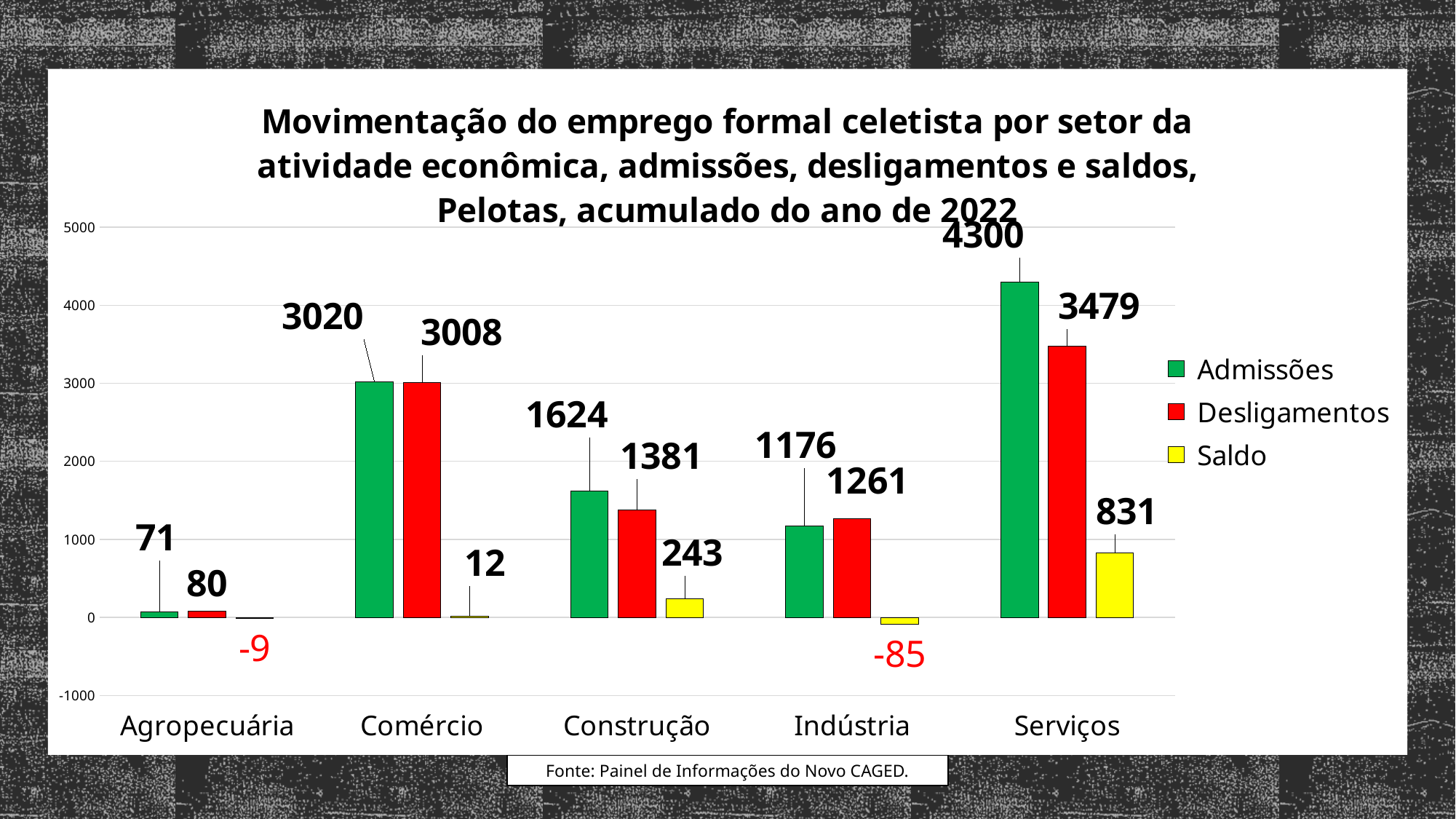
How many series does the legend list? 3 What is the Saldo value for Agropecuária? -9 Which sector has the highest Admissões value? Serviços What is the Desligamentos value for Comércio? 3008 What colour represents the Saldo series? Yellow What is the Admissões value for Serviços? 4300 Which is larger for Indústria, Admissões or Desligamentos? Desligamentos What is the Saldo value for Indústria? -85 How many sectors are shown on the x axis? 5 What is the difference between Admissões and Desligamentos for Construção? 243 What kind of chart is shown on the slide? Bar chart Which sector has the lowest Desligamentos value? Agropecuária